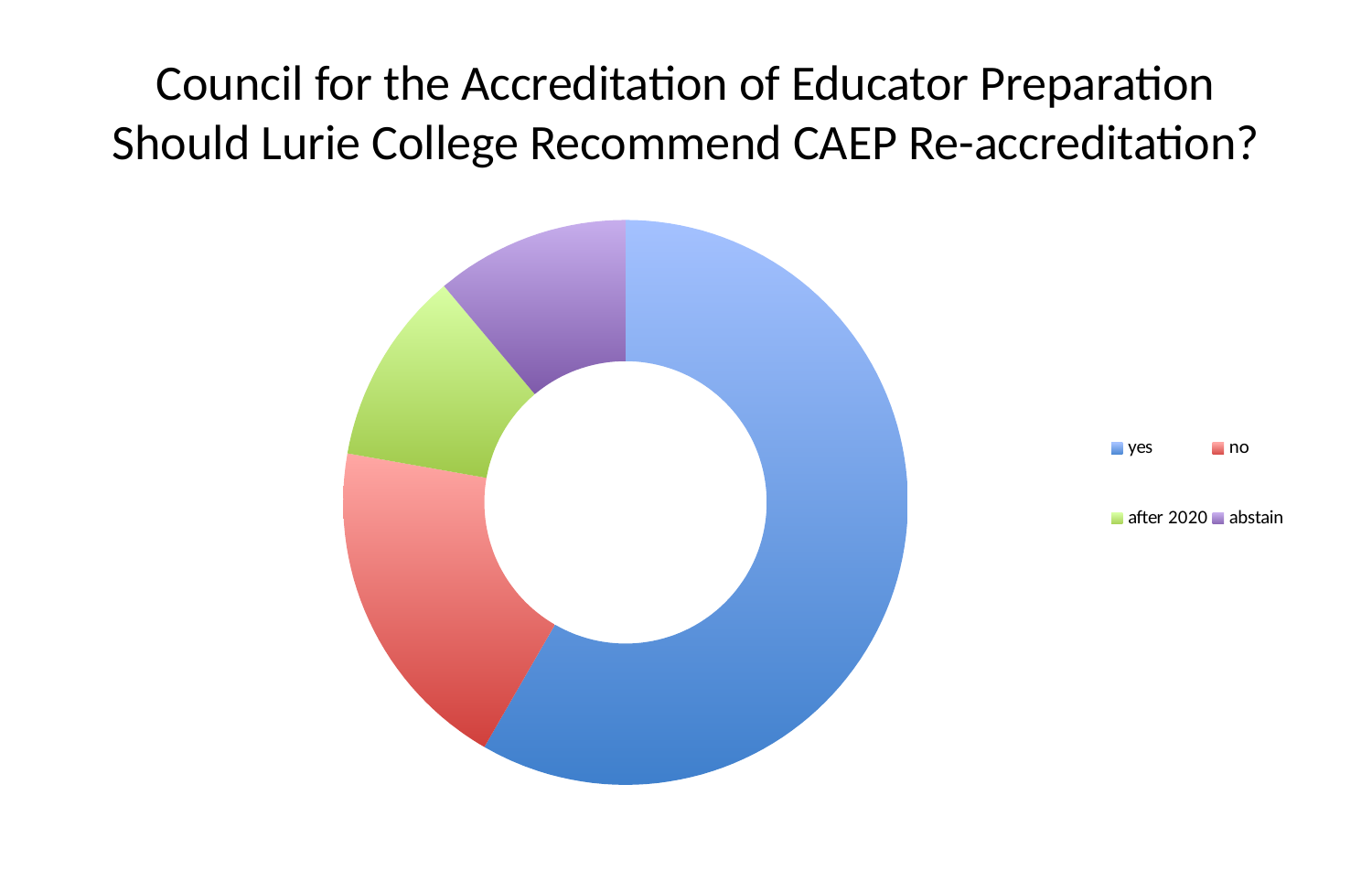
What kind of chart is shown on the slide? doughnut chart What colour is the after 2020 segment? green Which is larger, the share for yes or the share for no? yes What question does the chart title ask? Should Lurie College Recommend CAEP Re-accreditation? How many categories does the chart show? 4 Does the yes category account for more or less than half of the chart? more Which is larger, the share for no or the share for after 2020? no Which is larger, the share for no or the share for abstain? no Which category has the largest share of the chart? yes